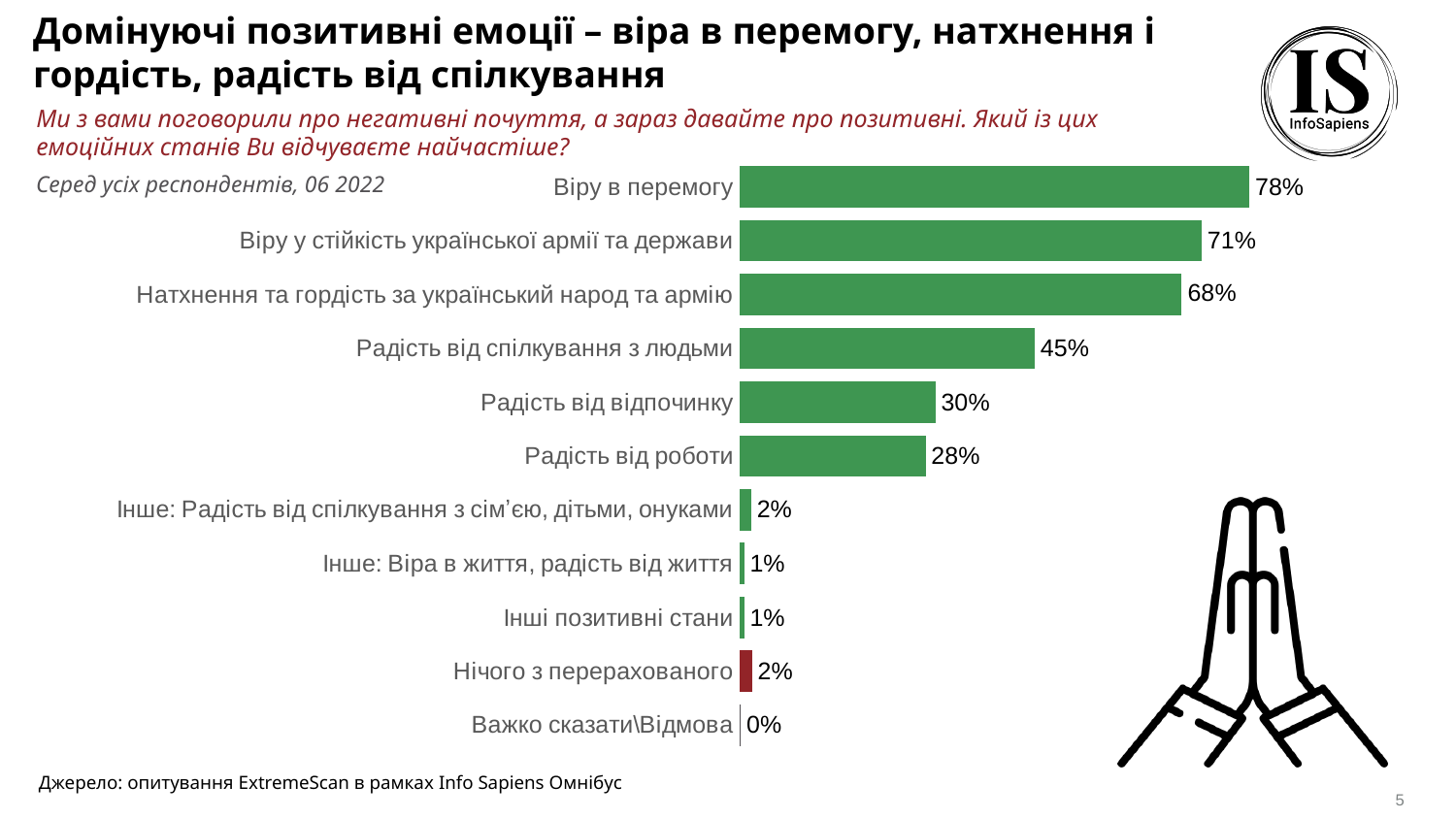
Which category has the highest value? Віру в перемогу What is the value for "Радість від спілкування з людьми"? 45% Which is larger: "Натхнення та гордість за український народ та армію" or "Радість від спілкування з людьми"? Натхнення та гордість за український народ та армію Which category has the lowest value? Важко сказати\Відмова What is the difference between "Віру в перемогу" and "Віру у стійкість української армії та держави"? 7% What is the difference between "Радість від відпочинку" and "Радість від роботи"? 2% What is the value for "Радість від роботи"? 28% What is the value for "Віру в перемогу"? 78% How many categories are shown in the chart? 11 What kind of chart is shown on the slide? Bar chart What is the value for "Нічого з перерахованого"? 2% Which bar is coloured differently (red) from the others? Нічого з перерахованого